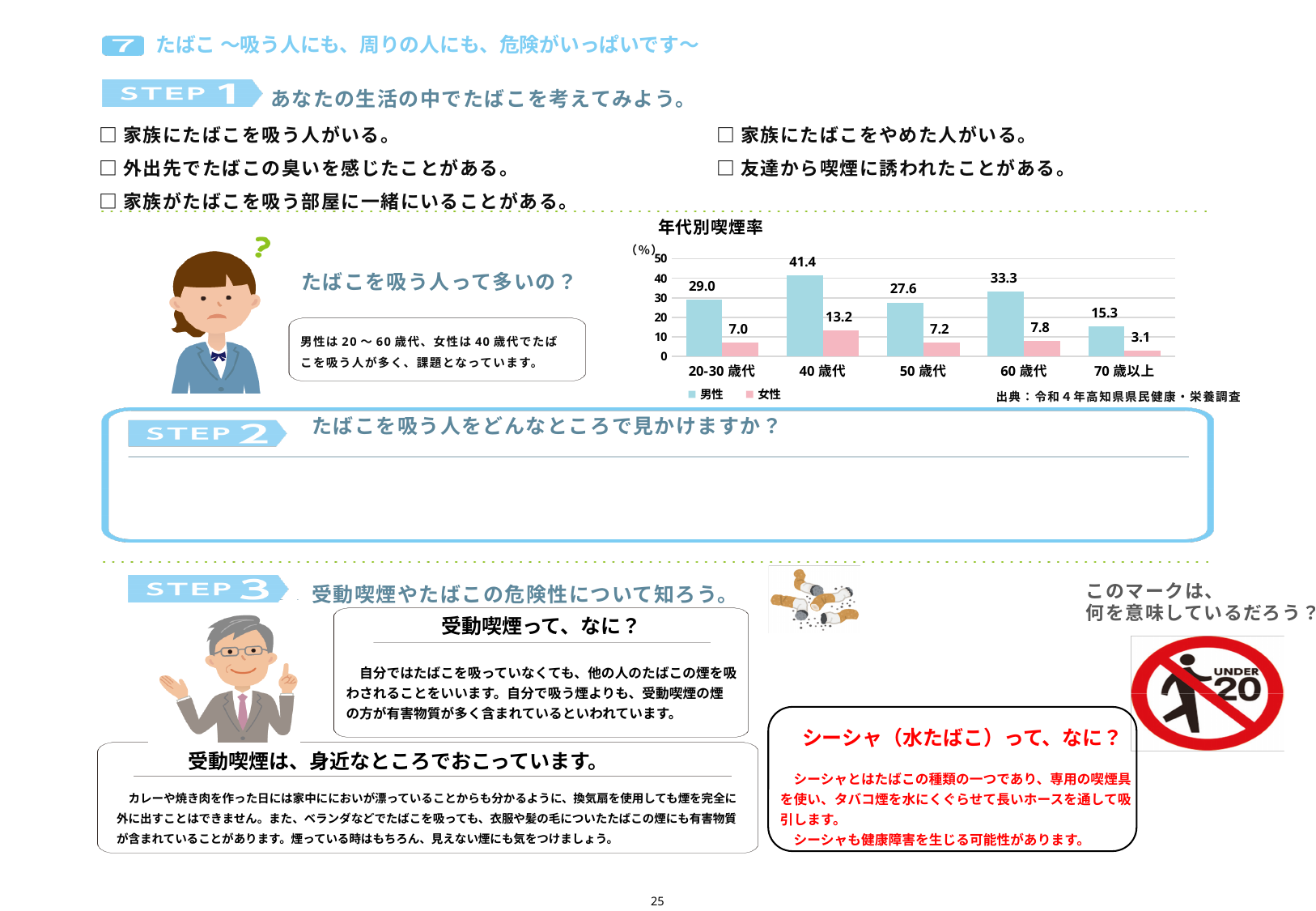
What is the difference between the 男性 and 女性 smoking rates in the 60 歳代 group? 25.5 Which age group has the highest 男性 smoking rate? 40 歳代 What is the smoking rate for 女性 in the 70 歳以上 group in the 年代別喫煙率 chart? 3.1 How many age groups are shown on the x axis of the 年代別喫煙率 chart? 5 What is the unit shown on the y axis of the 年代別喫煙率 chart? % What is the smoking rate for 男性 in the 40 歳代 group in the 年代別喫煙率 chart? 41.4 What kind of chart is the 年代別喫煙率 chart? bar chart What is the smoking rate for 女性 in the 20-30 歳代 group? 7.0 Is the 男性 smoking rate for 70 歳以上 greater or less than 20? less How many series does the legend of the 年代別喫煙率 chart list? 2 Which age group has the lowest 女性 smoking rate? 70 歳以上 Which is larger, the 男性 smoking rate for 20-30 歳代 or for 50 歳代? 20-30 歳代